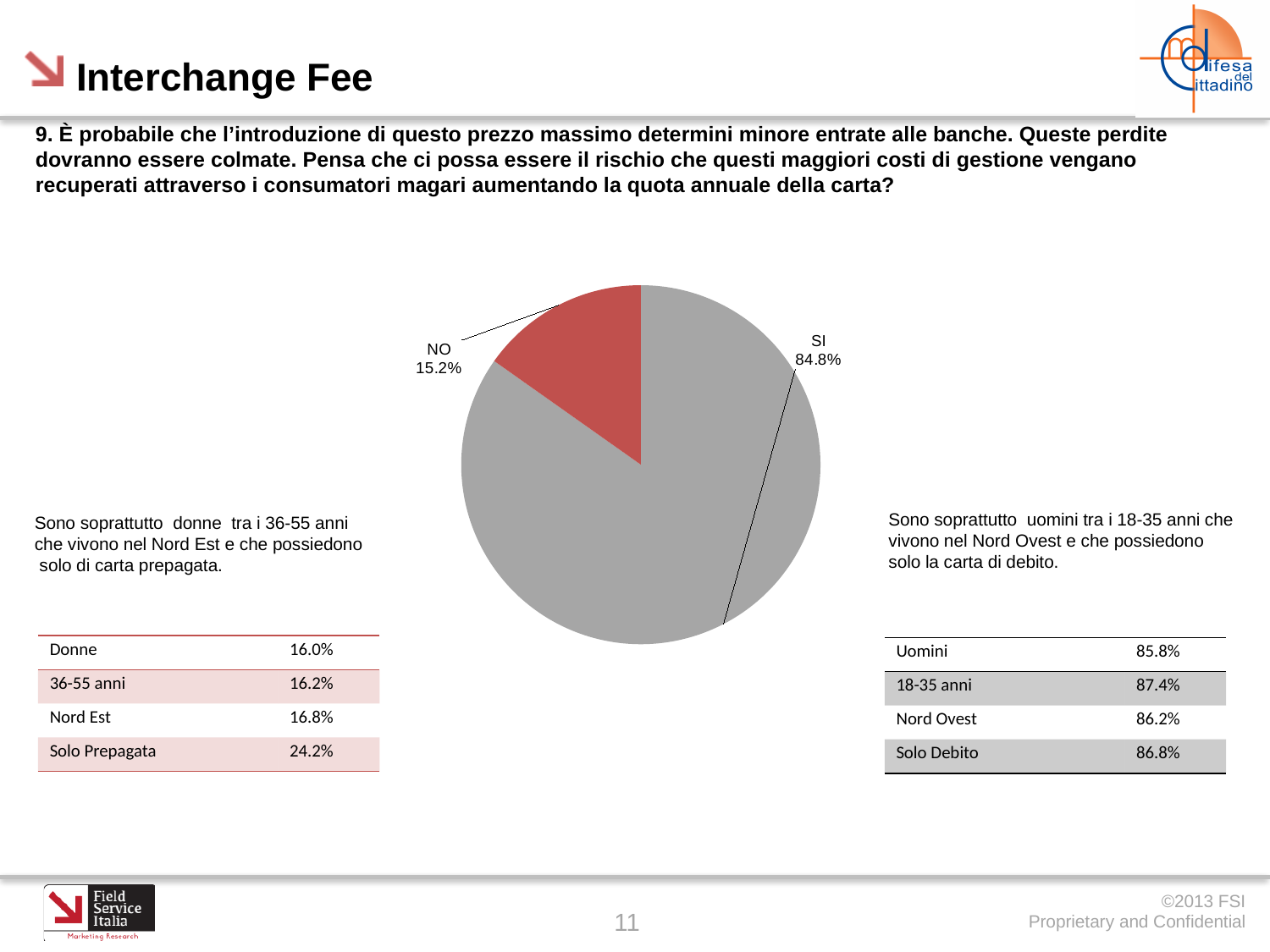
How many slices does the pie chart have? 2 Which is larger in the pie chart, SI or NO? SI What colour is the NO slice of the pie chart? red What is the value for the SI slice of the pie chart? 84.8% What colour is the SI slice of the pie chart? grey What is the difference between the SI and NO slices of the pie chart? 69.6% What is the value for the NO slice of the pie chart? 15.2% Which slice of the pie chart is the largest? SI What share of the pie does the NO slice represent? 15.2% Which slice of the pie chart is the smallest? NO What kind of chart is shown on the slide? pie chart